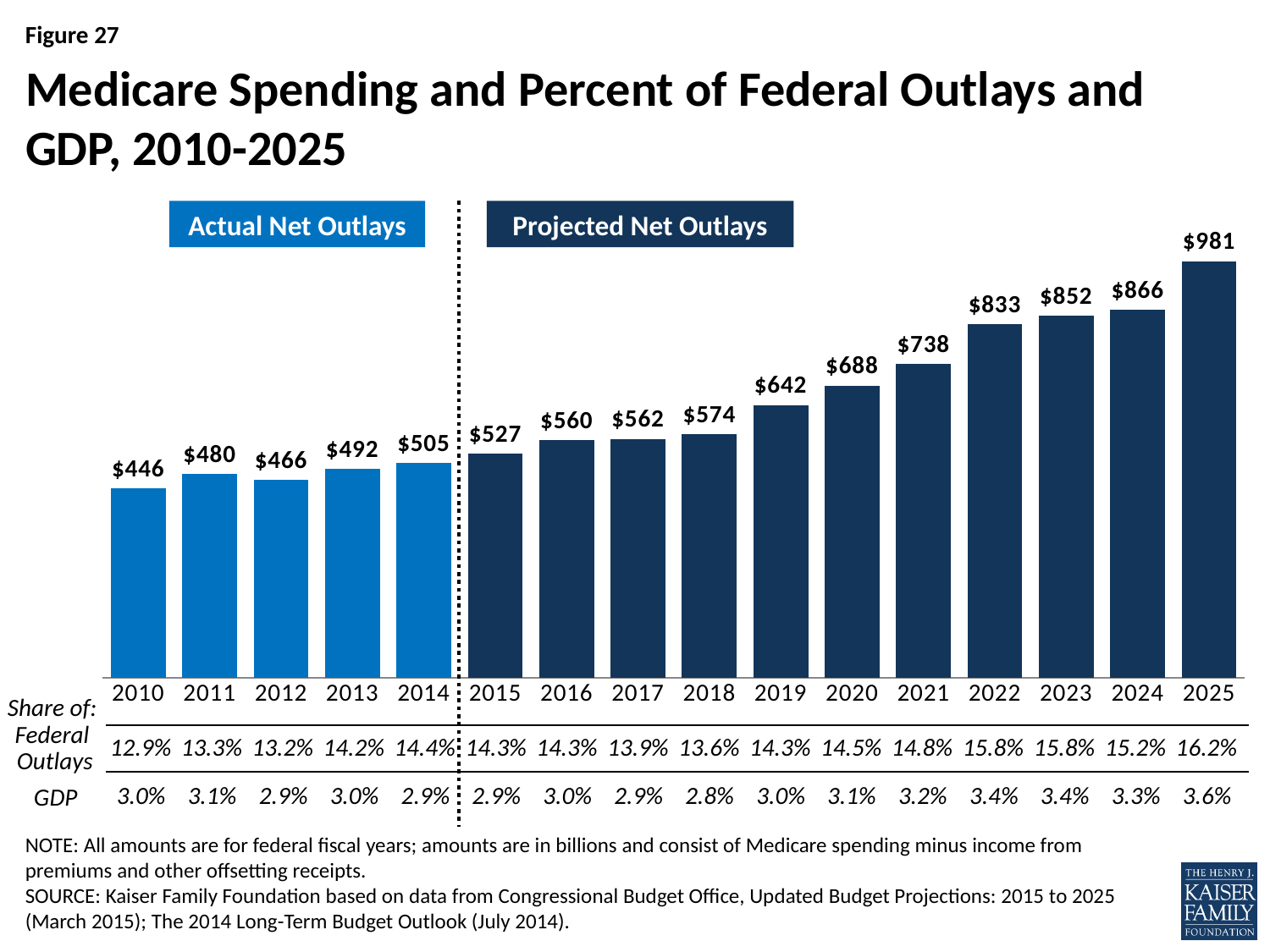
Do the Medicare spending values generally rise or fall from 2015 to 2025? Rise How many years are shown on the x axis of the chart? 16 What is the Medicare spending value shown for 2021? $738 What share of federal outlays is shown for 2025? 16.2% What is the Medicare spending value shown for 2014? $505 Which year has the lowest Medicare spending bar? 2010 Which year has the highest Medicare spending bar? 2025 What is the difference between the Medicare spending values for 2025 and 2024? $115 What kind of chart is used to show Medicare spending? Bar chart What label is given to the light blue bars in the chart? Actual Net Outlays What share of GDP is shown for 2018? 2.8% Which year has a larger Medicare spending value, 2011 or 2012? 2011